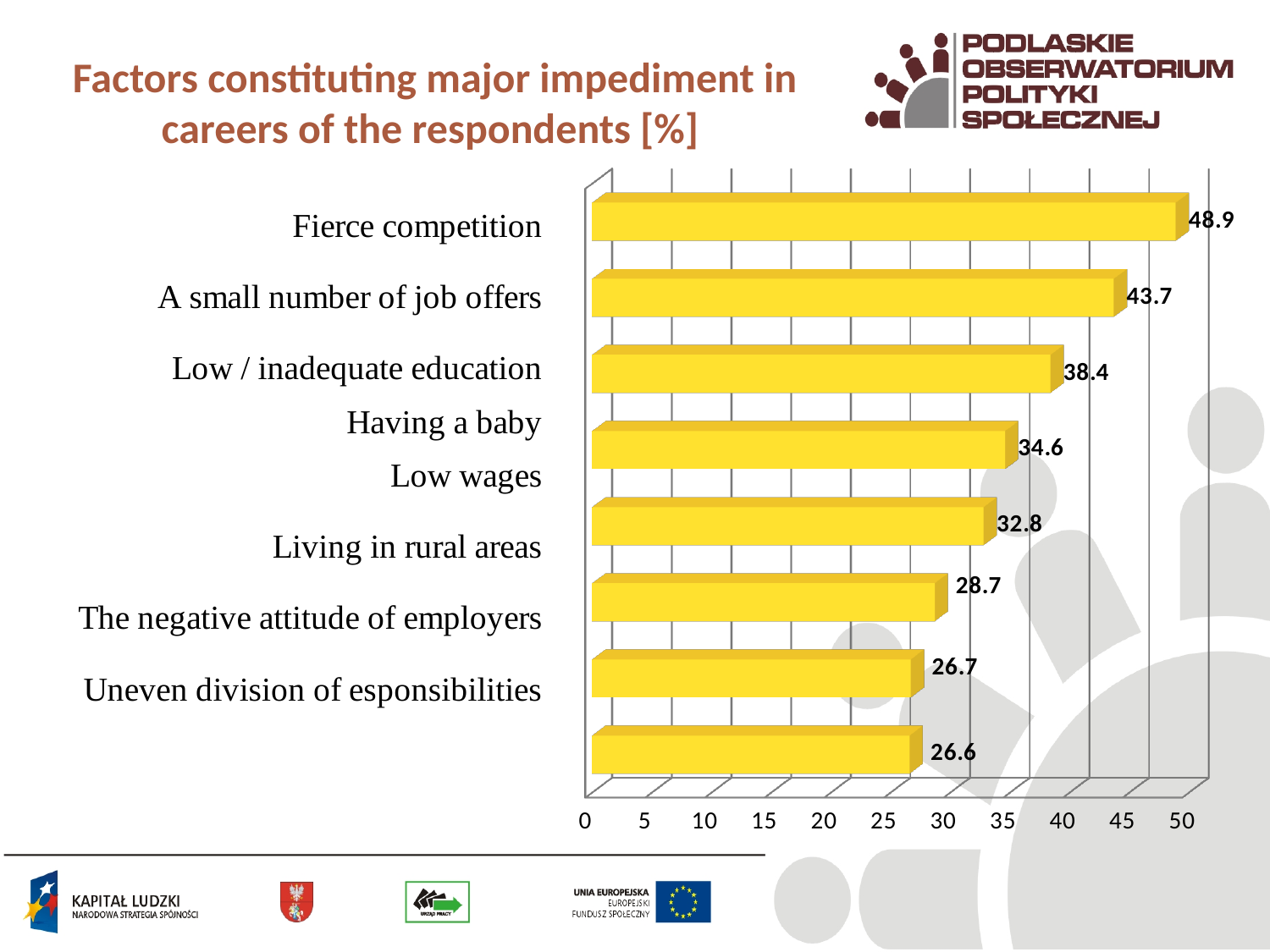
What is the value for A small number of job offers? 43.7 Do the bar values increase or decrease from the top of the chart to the bottom? decrease What is the value for Low / inadequate education? 38.4 Which factor has the highest value? Fierce competition Is the value for Fierce competition greater or less than 45? greater What is the difference between the values for Fierce competition and A small number of job offers? 5.2 What is the title of the chart? Factors constituting major impediment in careers of the respondents [%] What is the lowest value shown on the chart? 26.6 What kind of chart is shown on the slide? bar chart How many bars are shown on the chart? 8 What is the value for Fierce competition? 48.9 Which is larger, the value for Fierce competition or the value for Low / inadequate education? Fierce competition